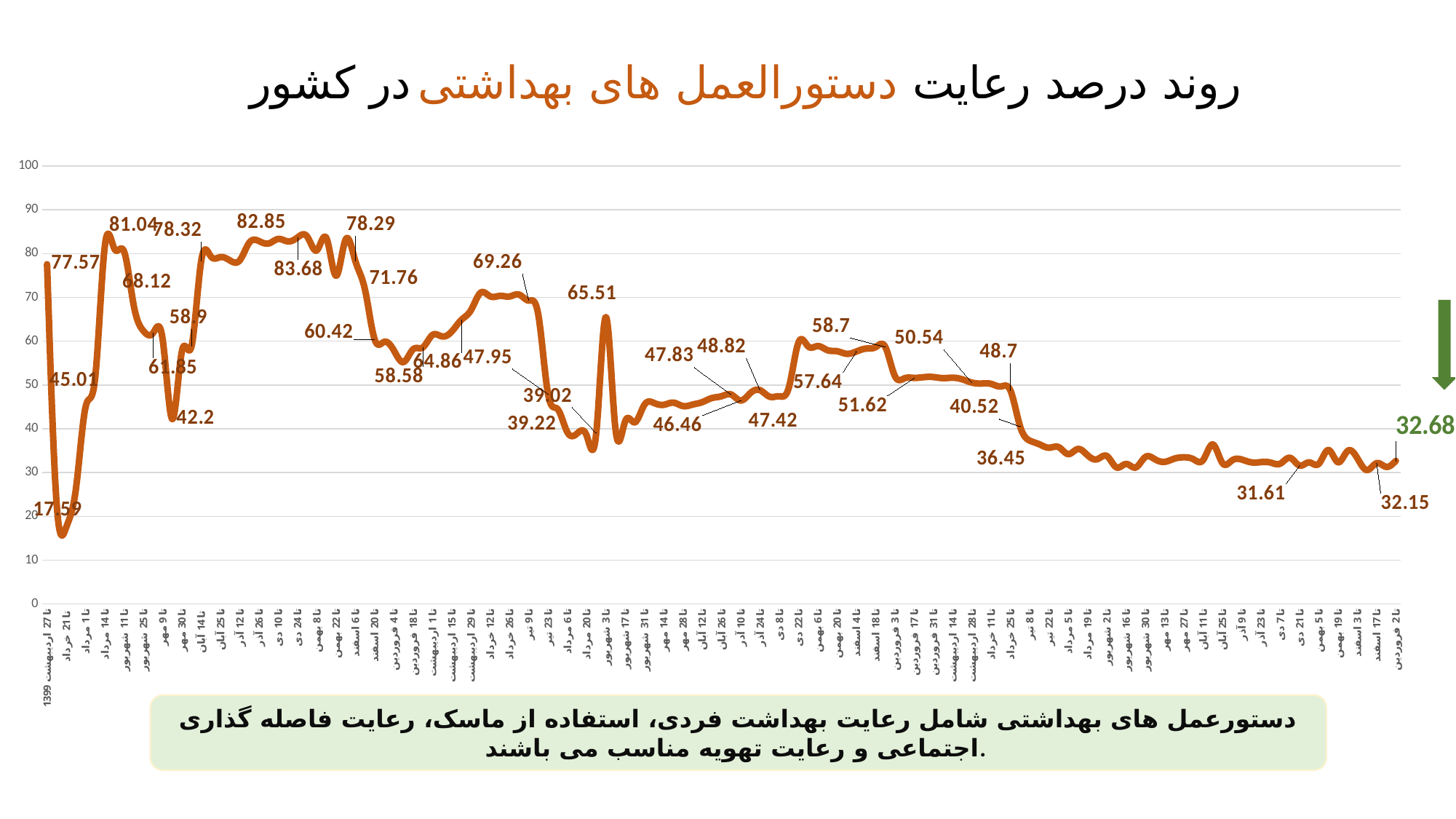
What is the difference between the highest labeled value (83.68) and the lowest labeled value (17.59)? 66.09 What is the value of the last data point on the right of the chart (shown in green)? 32.68 What kind of chart is shown on the slide? line chart What is the lowest labeled value on the chart? 17.59 What is the maximum value shown on the vertical axis? 100 Overall, is the value at the right end of the chart higher or lower than at the left end? lower How many data series are plotted on the chart? 1 What is the value of the first data point on the left of the chart (تا 27 اردیبهشت 1399)? 77.57 Which is larger, the labeled value 65.51 or the labeled value 69.26? 69.26 What is the highest labeled value on the chart? 83.68 Is the value of the last data point on the right greater or less than 40? less What is the difference between the first labeled value (77.57) and the last labeled value (32.68)? 44.89